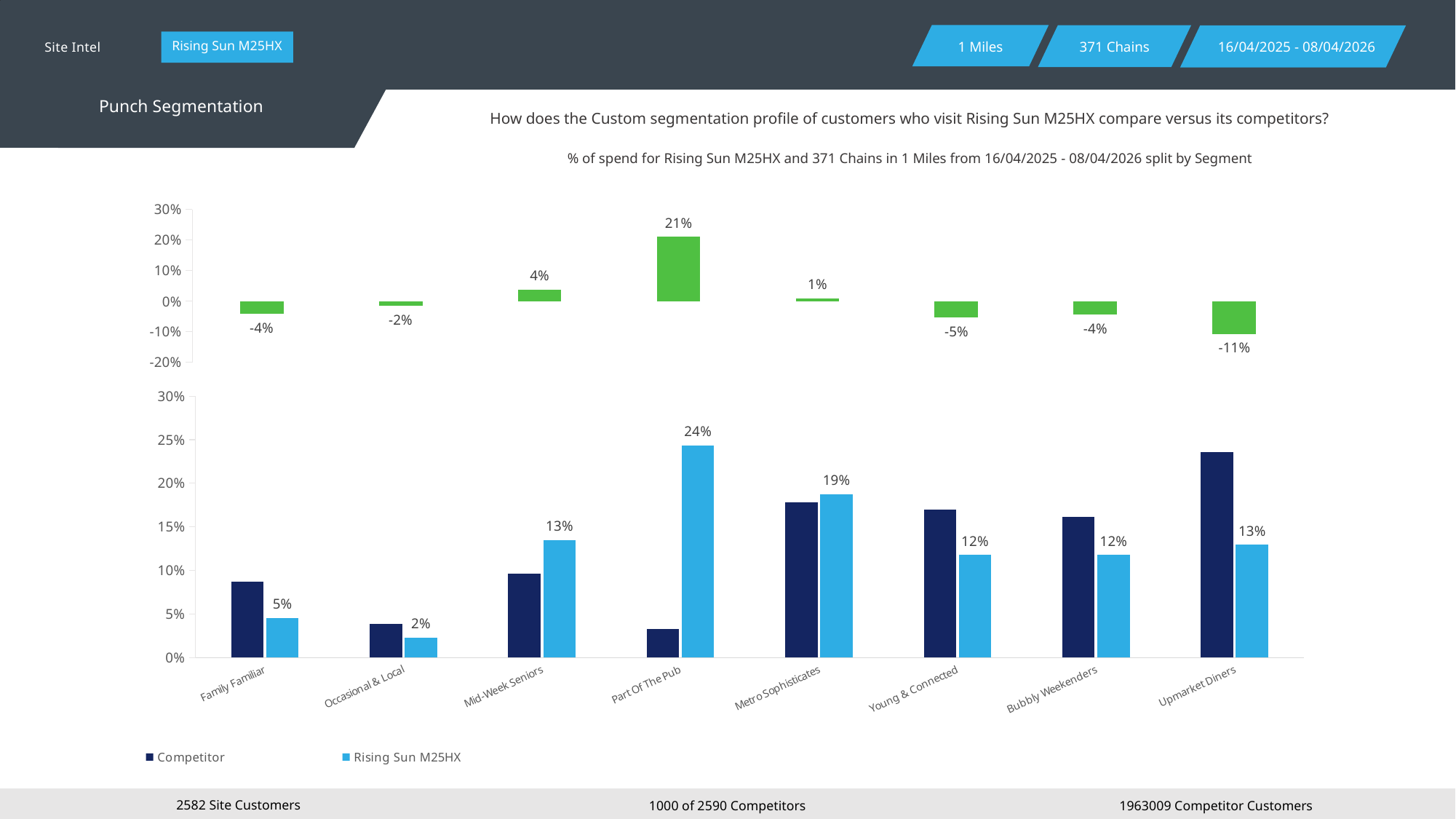
In the top chart, what is the value shown for Part Of The Pub? 21% In the bottom chart, which segment has the highest Rising Sun M25HX value? Part Of The Pub How many series does the legend of the bottom chart list? 2 In the bottom chart, is the Competitor value for Part Of The Pub greater or less than 5%? less In the top chart, what is the value shown for Young & Connected? -5% In the bottom chart, what is the difference between the Rising Sun M25HX values for Part Of The Pub and Family Familiar? 19 percentage points In the bottom chart, which segment has the lowest Rising Sun M25HX value? Occasional & Local In the bottom chart, what is the Rising Sun M25HX value for Metro Sophisticates? 19% In the bottom chart, for Upmarket Diners, which series has the larger value: Competitor or Rising Sun M25HX? Competitor How many segments are shown on the x axis of the bottom chart? 8 In the top chart, which segment has the lowest value? Upmarket Diners In the top chart, which segment has the highest value? Part Of The Pub